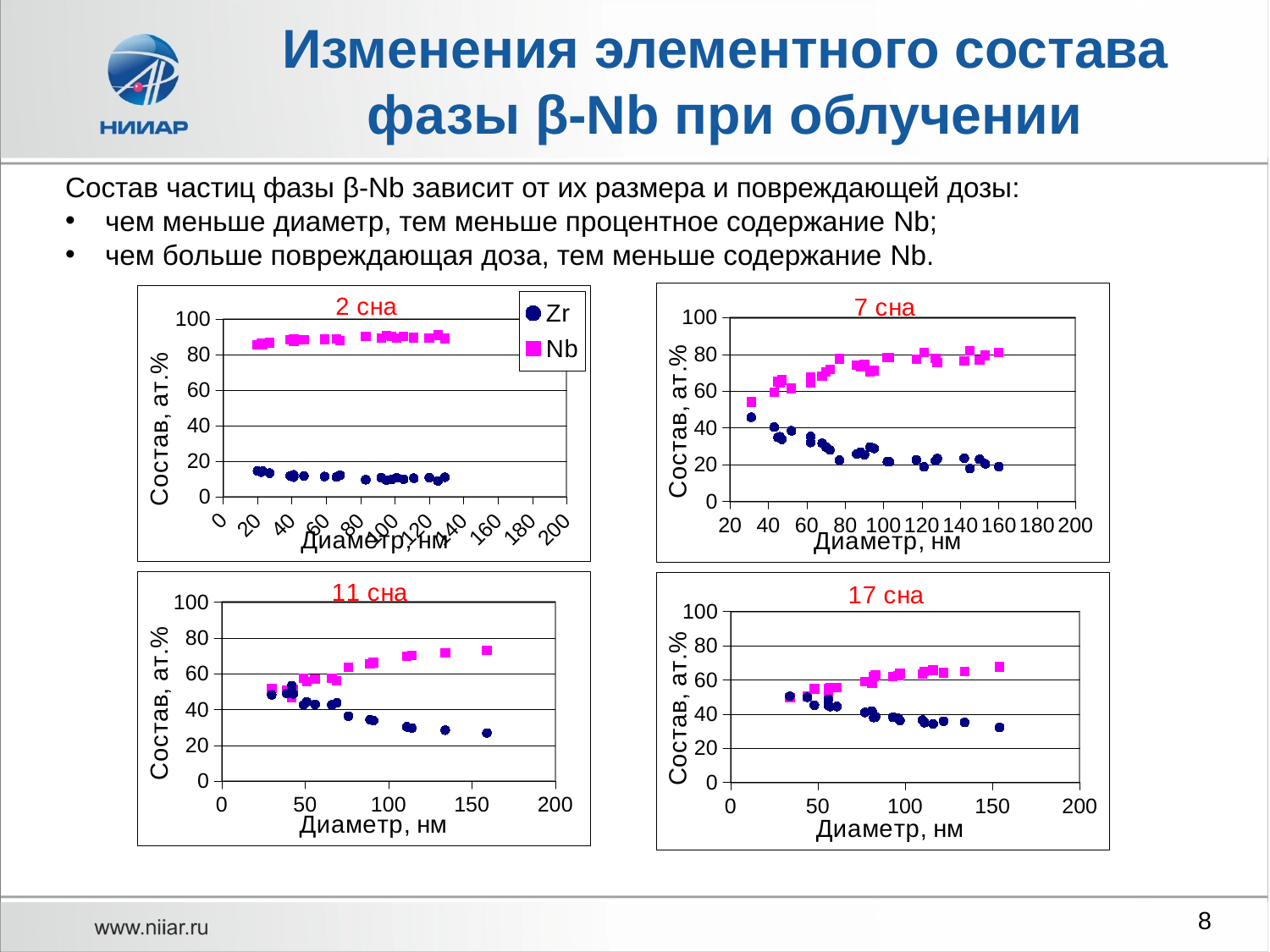
In the '7 сна' chart, is the Zr value at a diameter of about 160 nm greater or less than 40? less What are the two series named in the legend of the '2 сна' chart? Zr and Nb In the '2 сна' chart, which series has the higher values overall, Zr or Nb? Nb In the '11 сна' chart, do the Zr values rise or fall as the diameter increases? fall What is the y-axis label on the '7 сна' chart? Состав, ат.% In the '17 сна' chart, which series has the higher value at a diameter of about 150 nm, Zr or Nb? Nb How many series does the legend on the '2 сна' chart list? 2 In the '11 сна' chart, is the Nb value at a diameter of about 150 nm greater or less than 60? greater What kind of chart is the '2 сна' chart? scatter chart In the '2 сна' chart, are the Zr values greater or less than 20? less In the '7 сна' chart, do the Nb values rise or fall as the diameter increases? rise